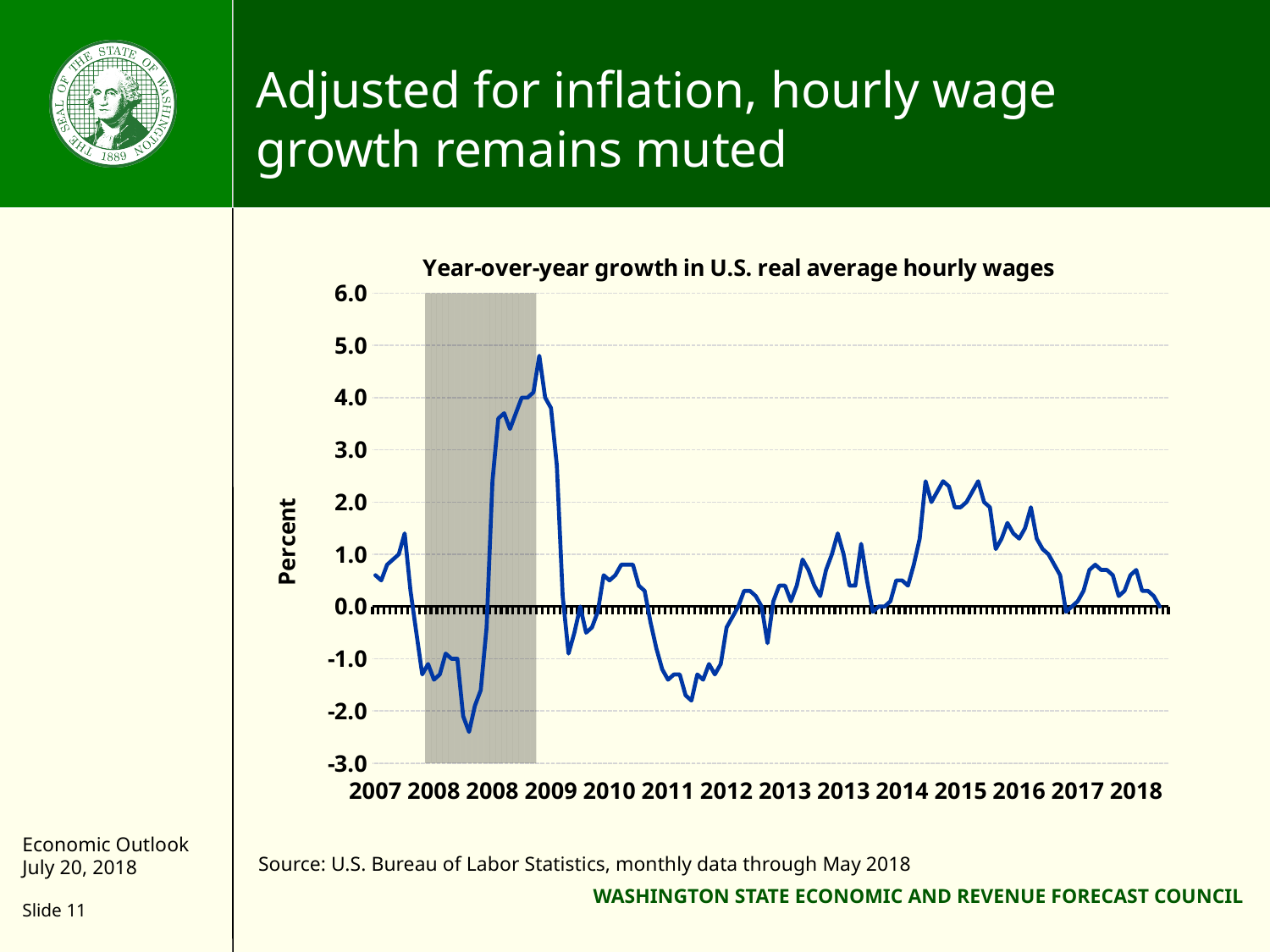
Is the value at the end of the line in 2018 greater or less than 1.0? less Is the lowest value reached by the line around 2012 greater or less than -1.0? less What is the highest value shown on the vertical axis? 6.0 Is the peak of the line in 2009 higher or lower than the peak around 2015? higher Is the highest value reached by the line around 2015 greater or less than 2.0? greater Does the line generally rise or fall between 2015 and 2018? fall What kind of chart is shown on the slide? line chart What is the title of the chart? Year-over-year growth in U.S. real average hourly wages What is the lowest value shown on the vertical axis? -3.0